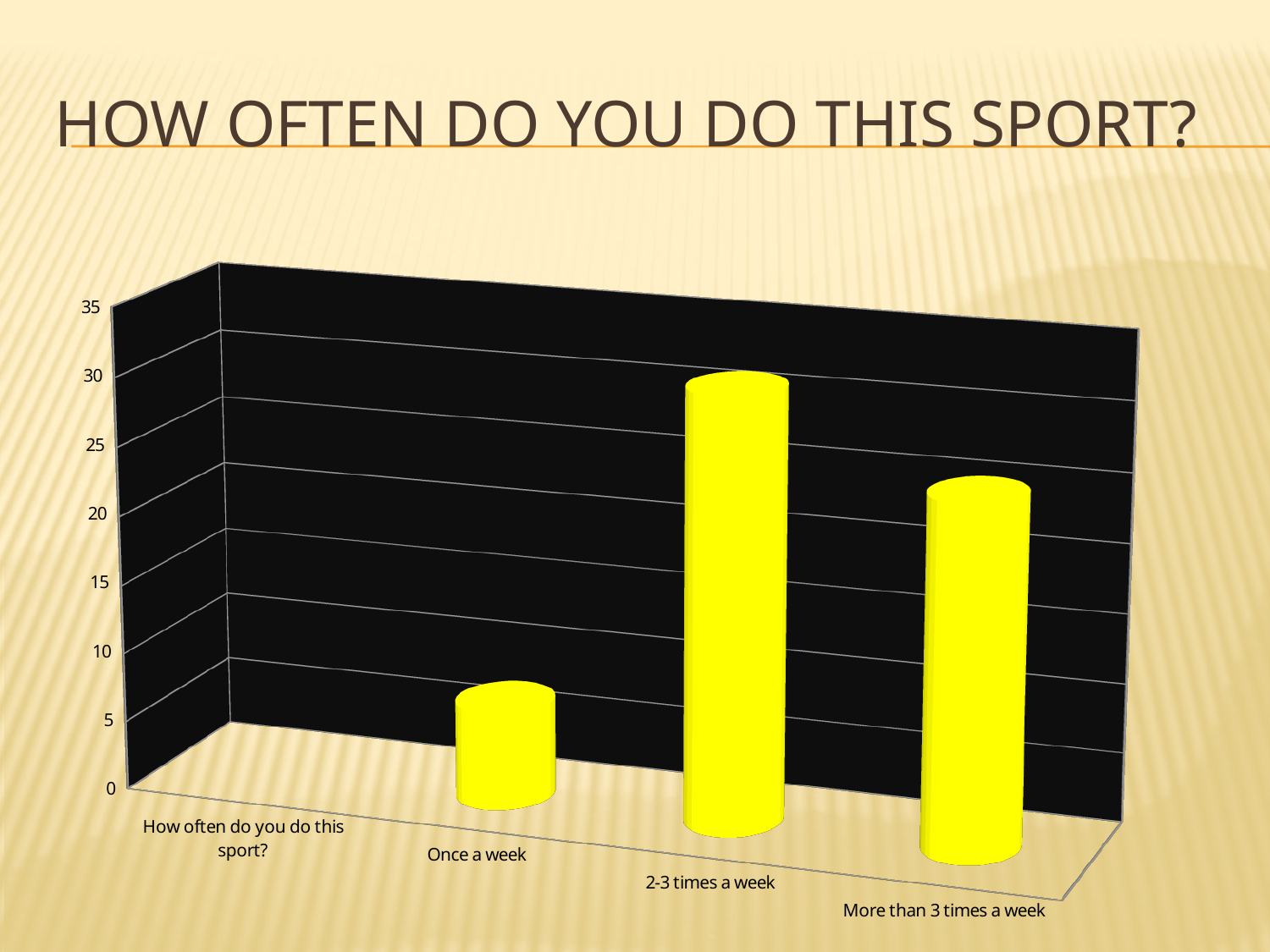
What colour are the bars in the chart? yellow Is the value for '2-3 times a week' greater or less than 25? greater Which of the plotted bars is the shortest? Once a week What kind of chart is shown on the slide? bar chart Is the value for 'More than 3 times a week' greater or less than 30? less Is the value for 'More than 3 times a week' greater or less than 15? greater What is the highest value shown on the vertical axis? 35 Which category has the tallest bar? 2-3 times a week Which is larger, the value for '2-3 times a week' or the value for 'More than 3 times a week'? 2-3 times a week How many bars are plotted in the chart? 3 Which is larger, the value for 'Once a week' or the value for 'More than 3 times a week'? More than 3 times a week